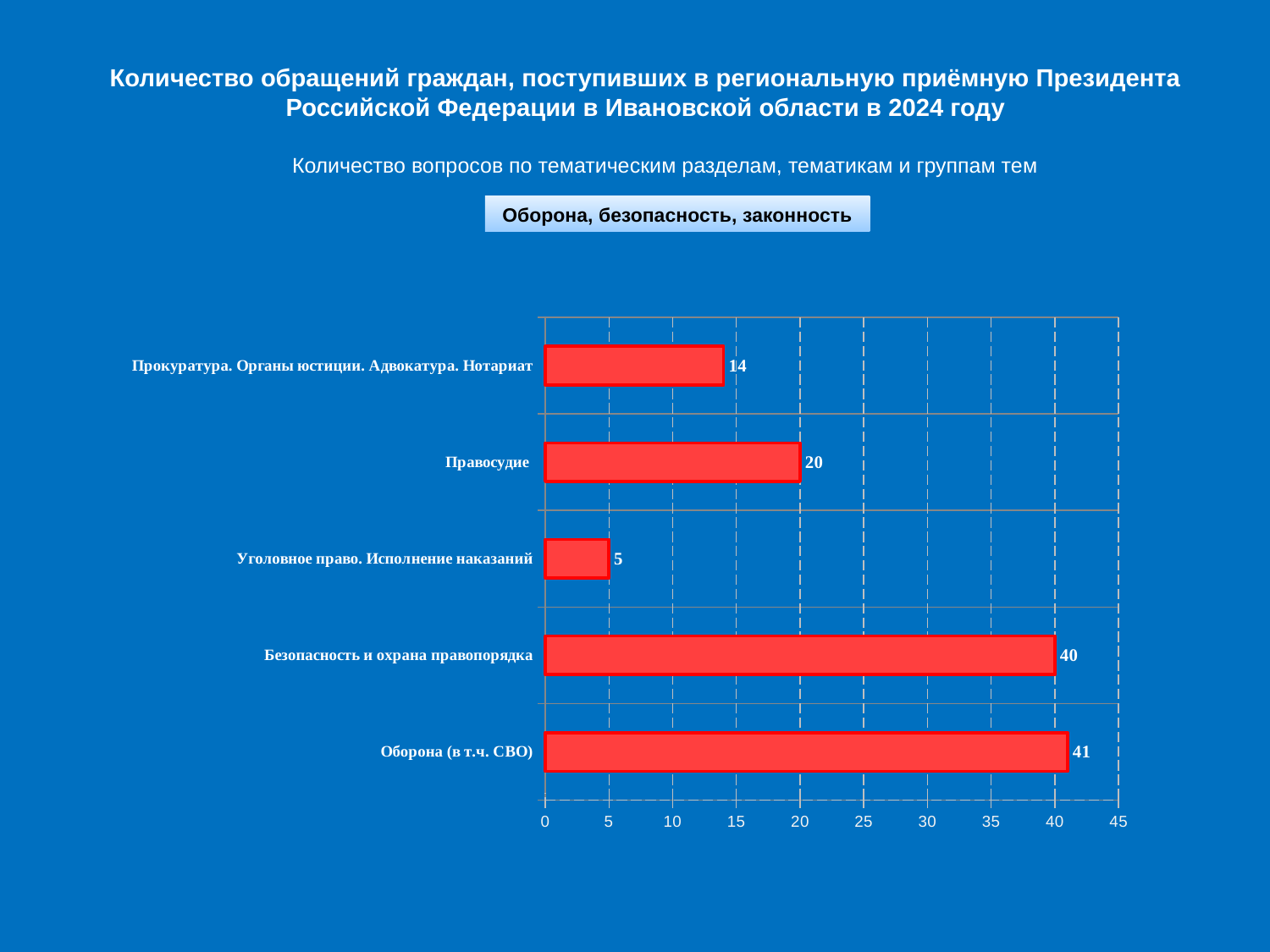
What is the heading shown above the chart? Оборона, безопасность, законность What is the value for Оборона (в т.ч. СВО)? 41 Is the value for Безопасность и охрана правопорядка greater or less than 35? greater What is the value for Правосудие? 20 Which category has the highest value? Оборона (в т.ч. СВО) What is the value for Уголовное право. Исполнение наказаний? 5 What is the difference between the values for Безопасность и охрана правопорядка and Правосудие? 20 How many categories are shown in the chart? 5 What kind of chart is shown on the slide? bar chart What is the value for Прокуратура. Органы юстиции. Адвокатура. Нотариат? 14 Which is larger: the value for Правосудие or the value for Прокуратура. Органы юстиции. Адвокатура. Нотариат? Правосудие Which category has the lowest value? Уголовное право. Исполнение наказаний